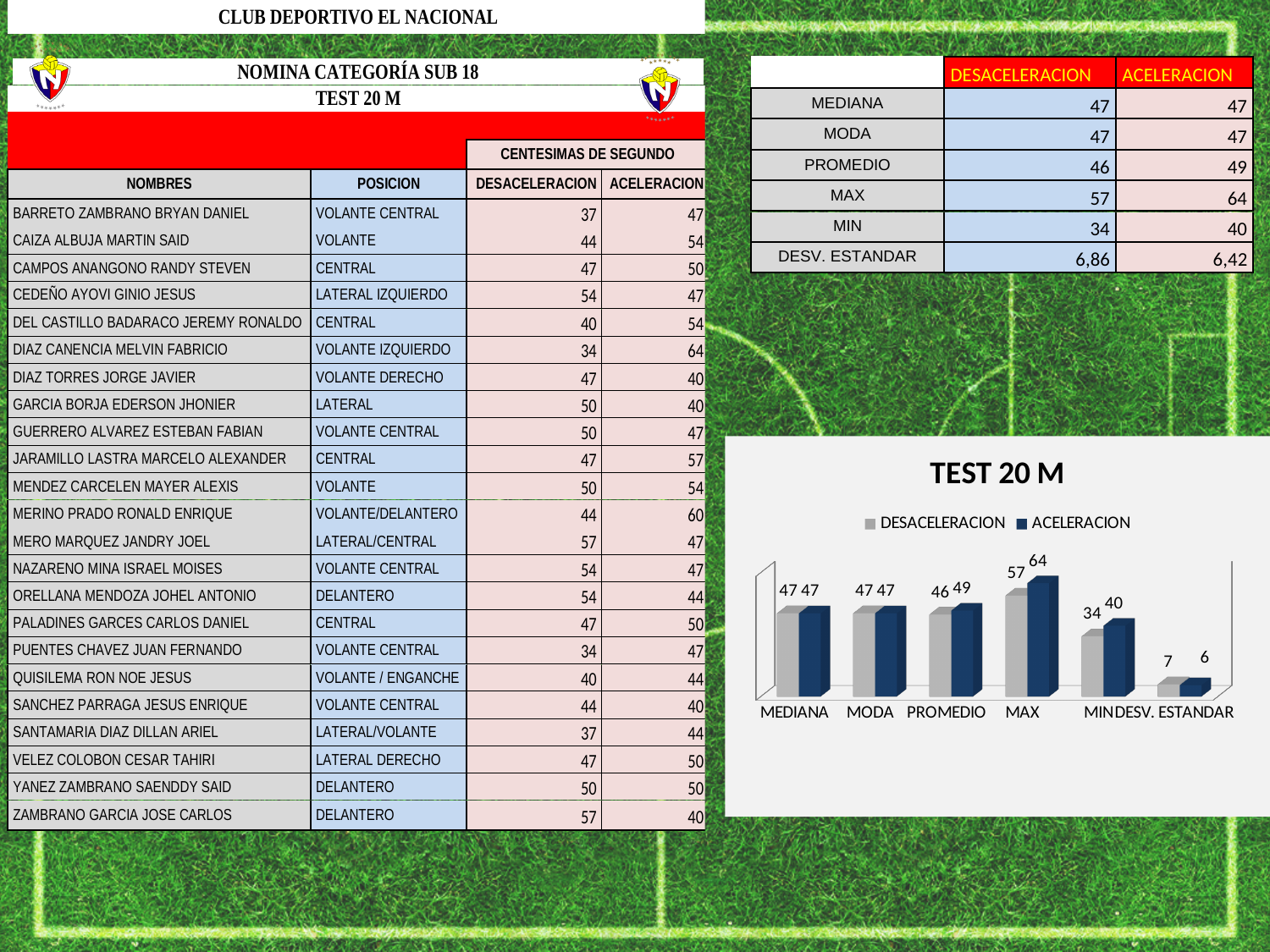
How many series does the legend of the TEST 20 M chart list? 2 In the TEST 20 M chart, what is the difference between the ACELERACION and DESACELERACION values for MAX? 7 In the TEST 20 M chart, what is the DESACELERACION value for DESV. ESTANDAR? 7 In the TEST 20 M chart, which is larger for MIN: DESACELERACION or ACELERACION? ACELERACION How many categories are shown on the x axis of the TEST 20 M chart? 6 What type of chart is shown under the title TEST 20 M? bar chart In the TEST 20 M chart, what is the ACELERACION value for MAX? 64 In the TEST 20 M chart, which colour represents the ACELERACION series? dark blue In the TEST 20 M chart, what is the ACELERACION value for PROMEDIO? 49 In the TEST 20 M chart, what is the DESACELERACION value for MIN? 34 In the TEST 20 M chart, which category has the highest ACELERACION value? MAX In the TEST 20 M chart, which category has the lowest DESACELERACION value? DESV. ESTANDAR